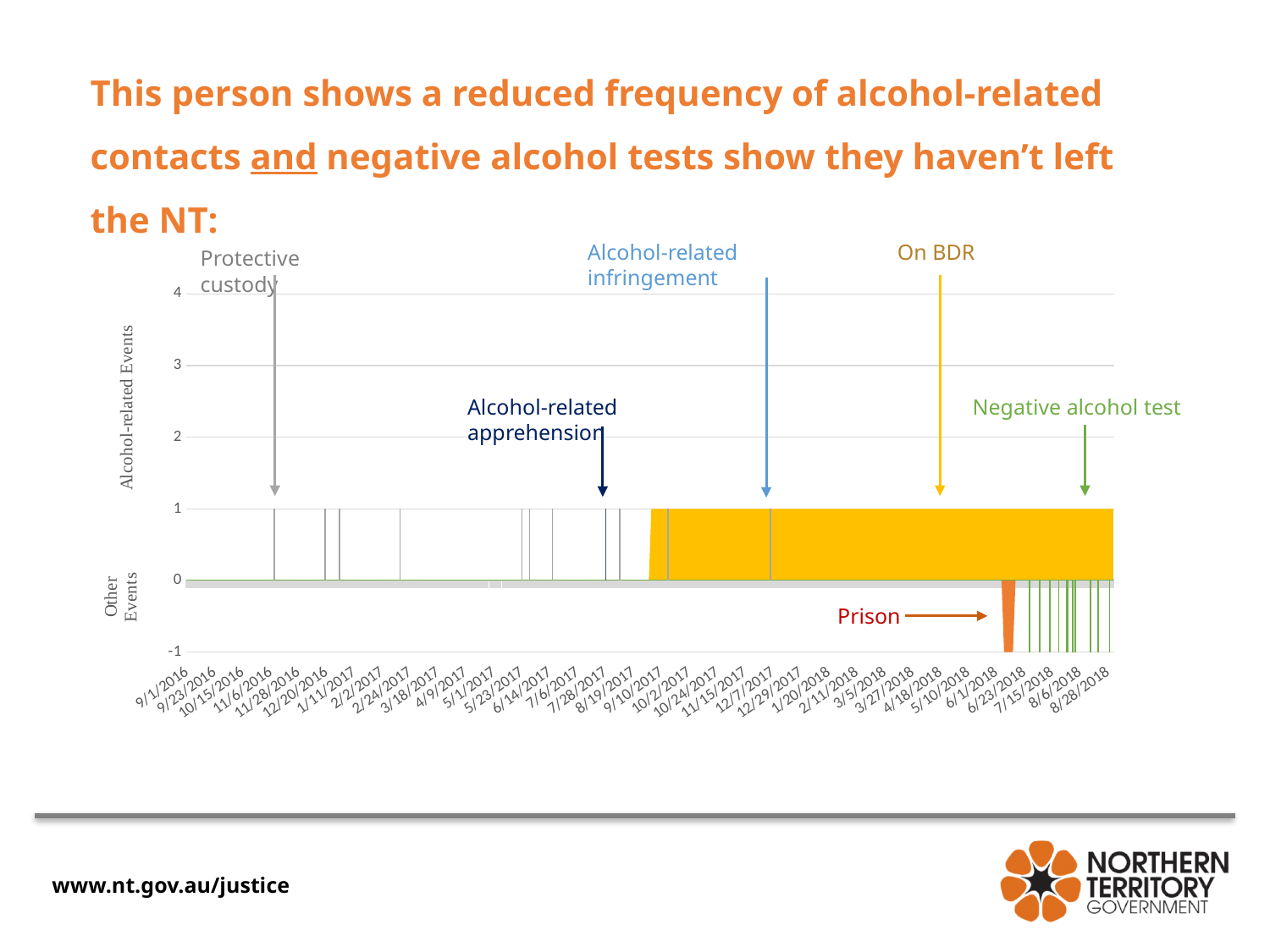
What is the first date shown on the horizontal axis of the chart? 9/1/2016 Does the frequency of alcohol-related events increase or decrease over the period shown? decrease How many different event types are annotated on the chart? 6 What value do the negative alcohol test bars reach on the vertical axis? -1 What is the lowest value shown on the vertical axis of the chart? -1 What is the label of the upper section of the vertical axis? Alcohol-related Events What value do the alcohol-related event bars reach on the vertical axis? 1 Which event type is annotated in green on the chart? Negative alcohol test What kind of chart is shown on the slide? bar chart Are there more alcohol-related events before or after the On BDR period begins? before What is the last date shown on the horizontal axis of the chart? 8/28/2018 What is the highest value shown on the vertical axis of the chart? 4